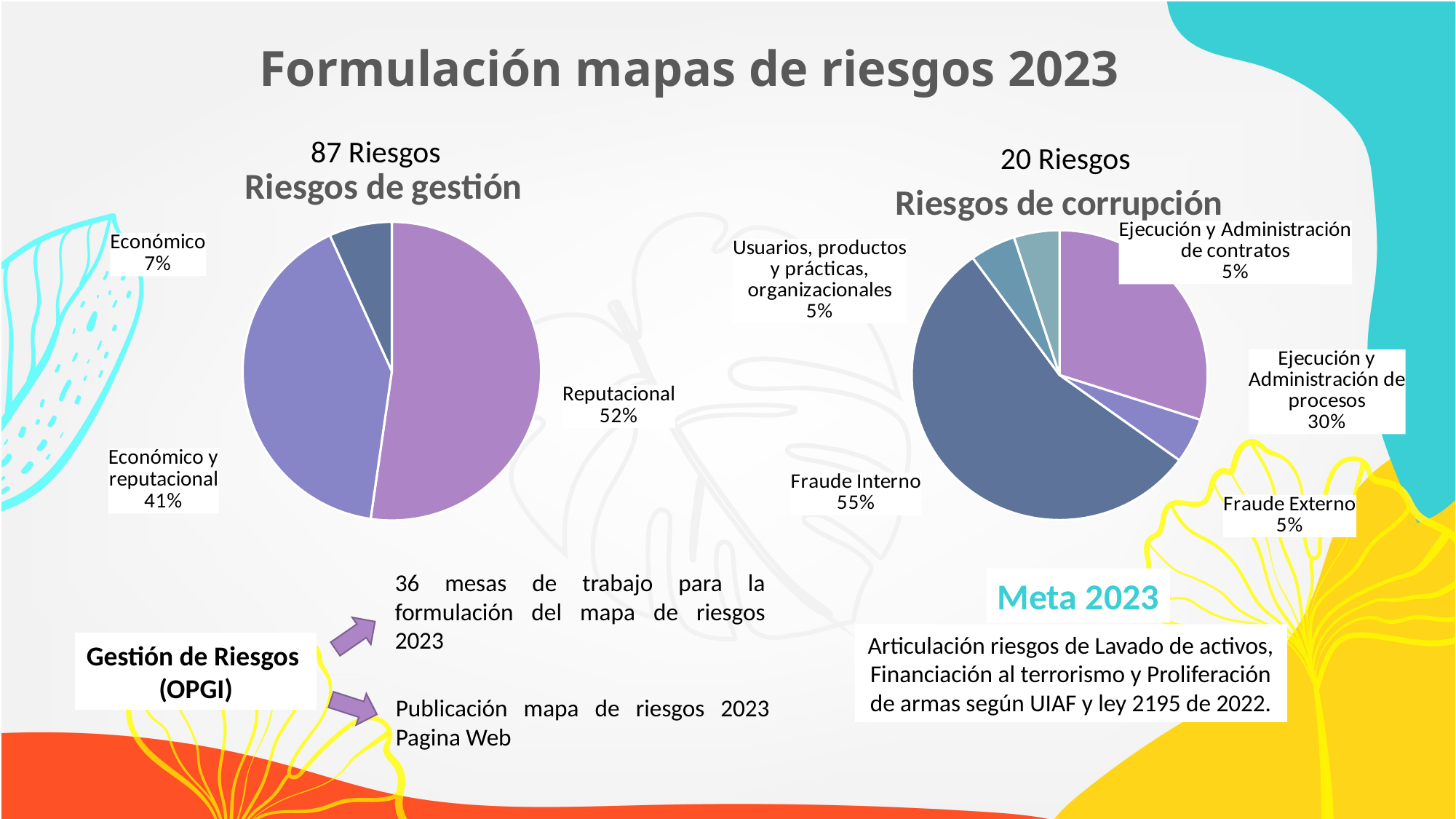
In the 'Riesgos de gestión' chart, which category has the largest slice? Reputacional In the 'Riesgos de gestión' chart, what share is labelled for Reputacional? 52% In the 'Riesgos de corrupción' chart, which is larger: Fraude Interno or Fraude Externo? Fraude Interno How many slices does the 'Riesgos de corrupción' pie chart have? 5 In the 'Riesgos de gestión' chart, what is the difference between the Reputacional and Económico y reputacional shares? 11% How many slices does the 'Riesgos de gestión' pie chart have? 3 What type of chart is used for 'Riesgos de corrupción'? Pie chart In the 'Riesgos de gestión' chart, what share is labelled for Económico? 7% In the 'Riesgos de corrupción' chart, what share is labelled for Fraude Interno? 55% In the 'Riesgos de corrupción' chart, what share is labelled for Ejecución y Administración de procesos? 30% In the 'Riesgos de gestión' chart, which category has the smallest slice? Económico In the 'Riesgos de corrupción' chart, which category has the largest slice? Fraude Interno